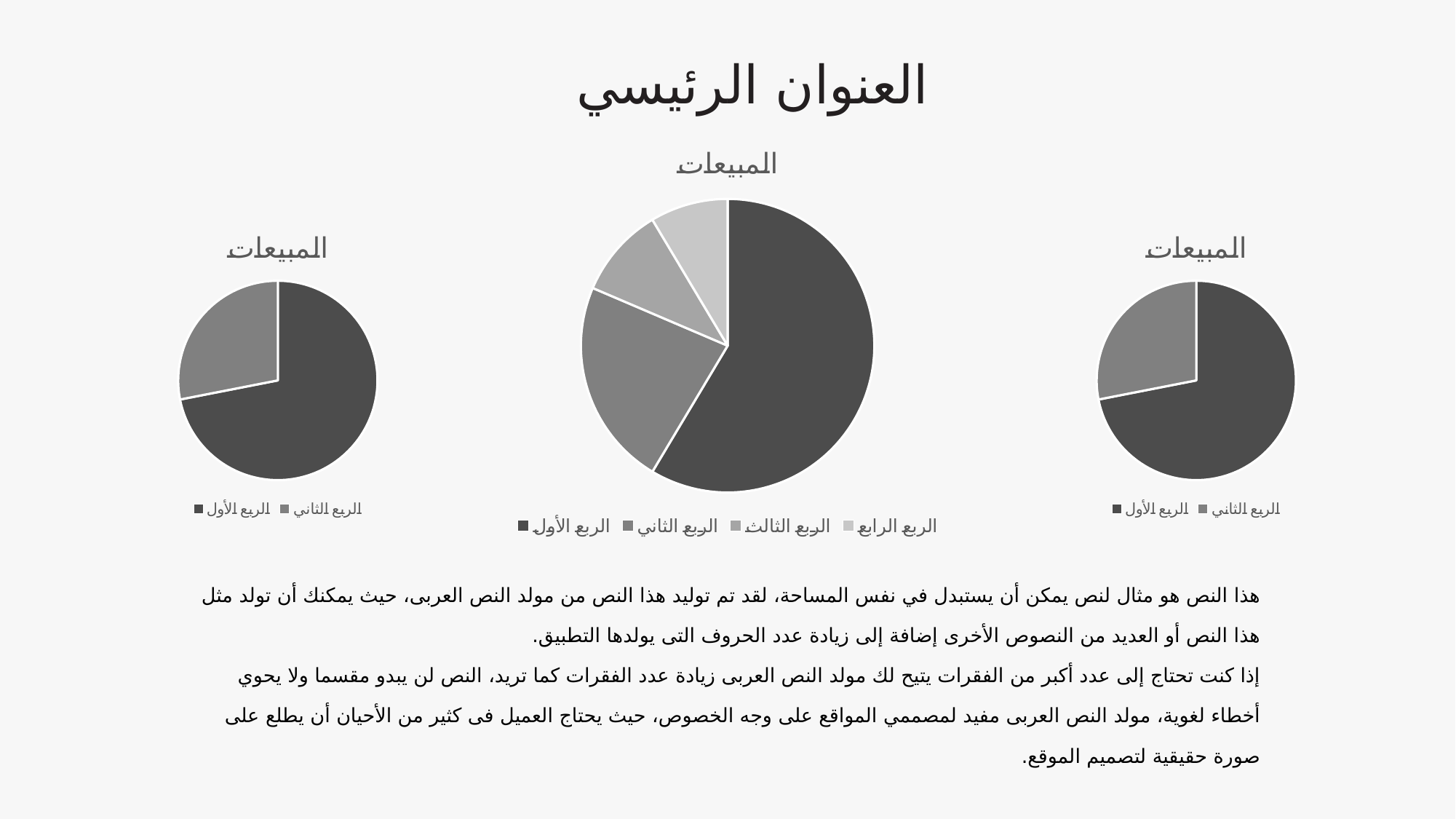
How many slices does the center pie chart have? 4 What is the title of the center pie chart? المبيعات How many entries does the legend of the center pie chart list? 4 What kind of chart is the center chart on the slide? Pie chart What kind of chart is the left chart on the slide? Pie chart In the left pie chart, which category has the largest slice? الربع الأول How many slices does the left pie chart have? 2 How many slices does the right pie chart have? 2 In the center pie chart, which slice is larger: الربع الثاني or الربع الثالث? الربع الثاني In the center pie chart, which category has the largest slice? الربع الأول How many entries does the legend of the right pie chart list? 2 In the right pie chart, which category has the smallest slice? الربع الثاني